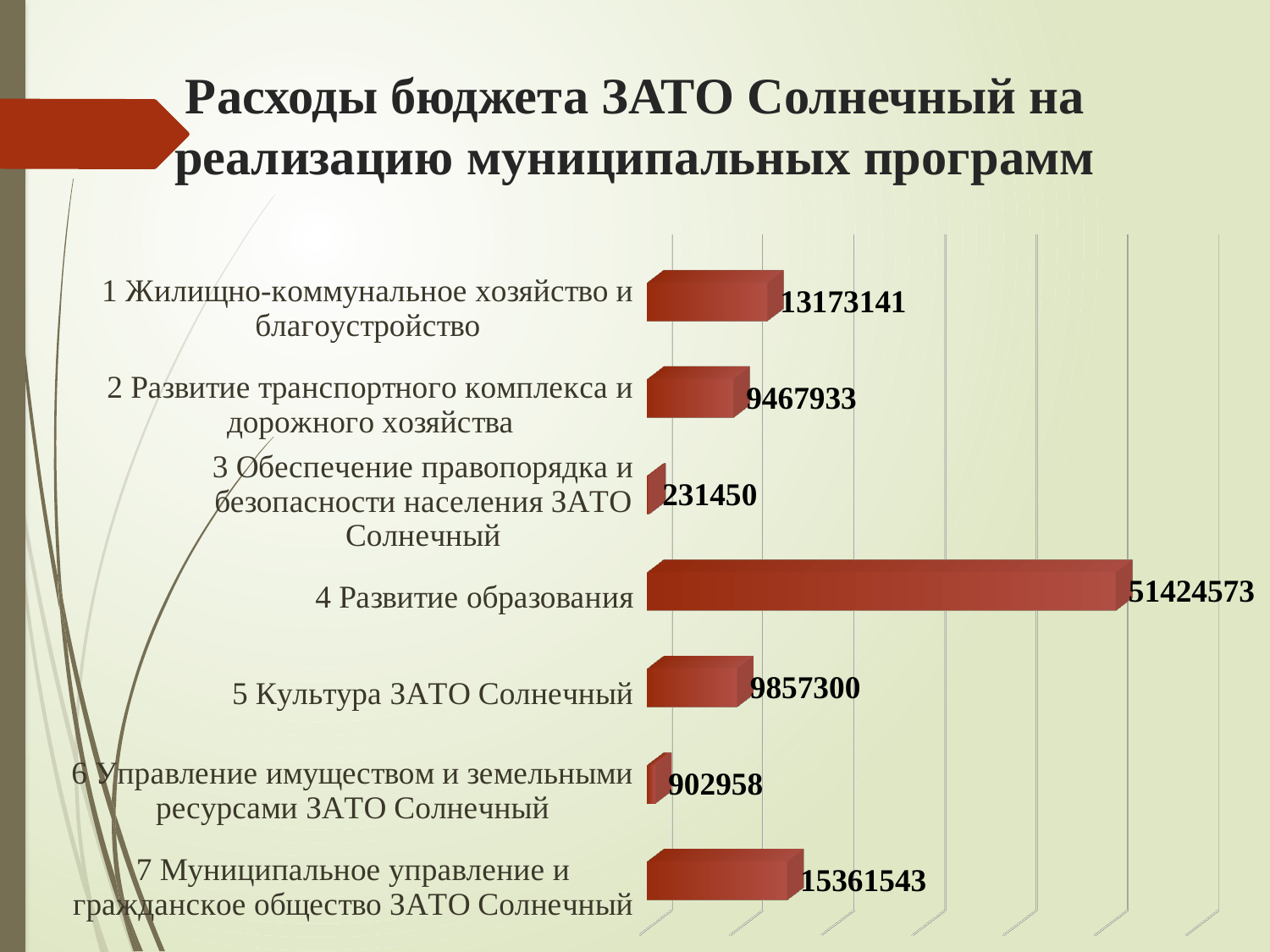
What is the value for "5 Культура ЗАТО Солнечный"? 9857300 Which program has the highest budget expenditure? 4 Развитие образования What is the value for "3 Обеспечение правопорядка и безопасности населения ЗАТО Солнечный"? 231450 What is the difference between the values for "5 Культура ЗАТО Солнечный" and "2 Развитие транспортного комплекса и дорожного хозяйства"? 389367 Which program has the lowest budget expenditure? 3 Обеспечение правопорядка и безопасности населения ЗАТО Солнечный What is the value for "4 Развитие образования"? 51424573 How many categories (programs) are shown in the chart? 7 Which is larger: the value for "1 Жилищно-коммунальное хозяйство и благоустройство" or for "2 Развитие транспортного комплекса и дорожного хозяйства"? 1 Жилищно-коммунальное хозяйство и благоустройство What is the value for "7 Муниципальное управление и гражданское общество ЗАТО Солнечный"? 15361543 What type of chart is shown on the slide? bar chart What is the title of the slide containing the chart? Расходы бюджета ЗАТО Солнечный на реализацию муниципальных программ What is the difference between the values for "7 Муниципальное управление и гражданское общество ЗАТО Солнечный" and "1 Жилищно-коммунальное хозяйство и благоустройство"? 2188402